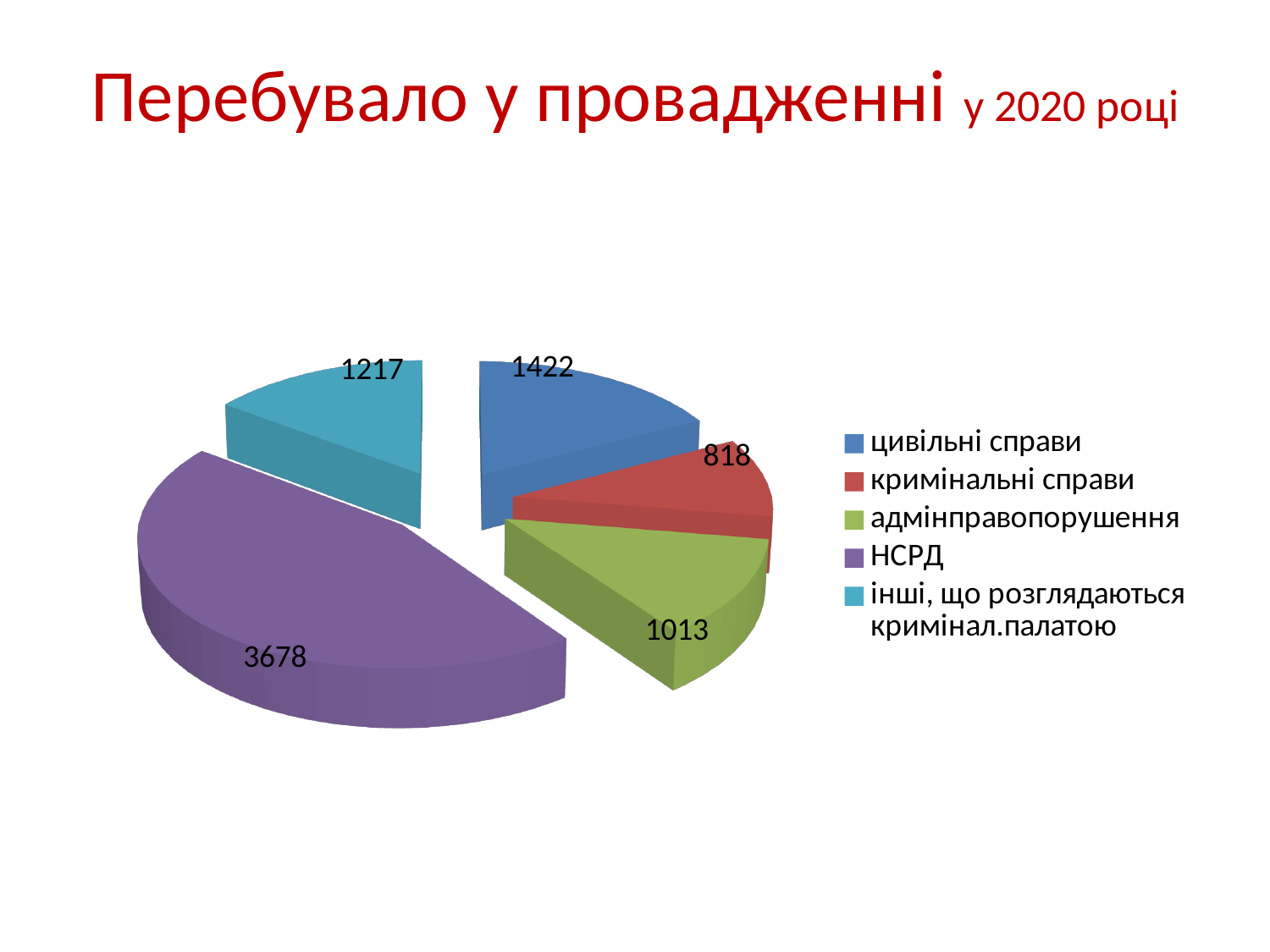
What is the value for НСРД? 3678 What colour is the slice for НСРД? purple What is the value for цивільні справи? 1422 What is the value for інші, що розглядаються кримінал.палатою? 1217 Which category has the largest slice of the pie? НСРД Which category has the smallest slice of the pie? кримінальні справи What is the difference between the values for НСРД and цивільні справи? 2256 What is the value for кримінальні справи? 818 Which is larger, the value for адмінправопорушення or the value for кримінальні справи? адмінправопорушення How many categories does the pie chart have? 5 What is the value for адмінправопорушення? 1013 What kind of chart is shown on the slide? pie chart